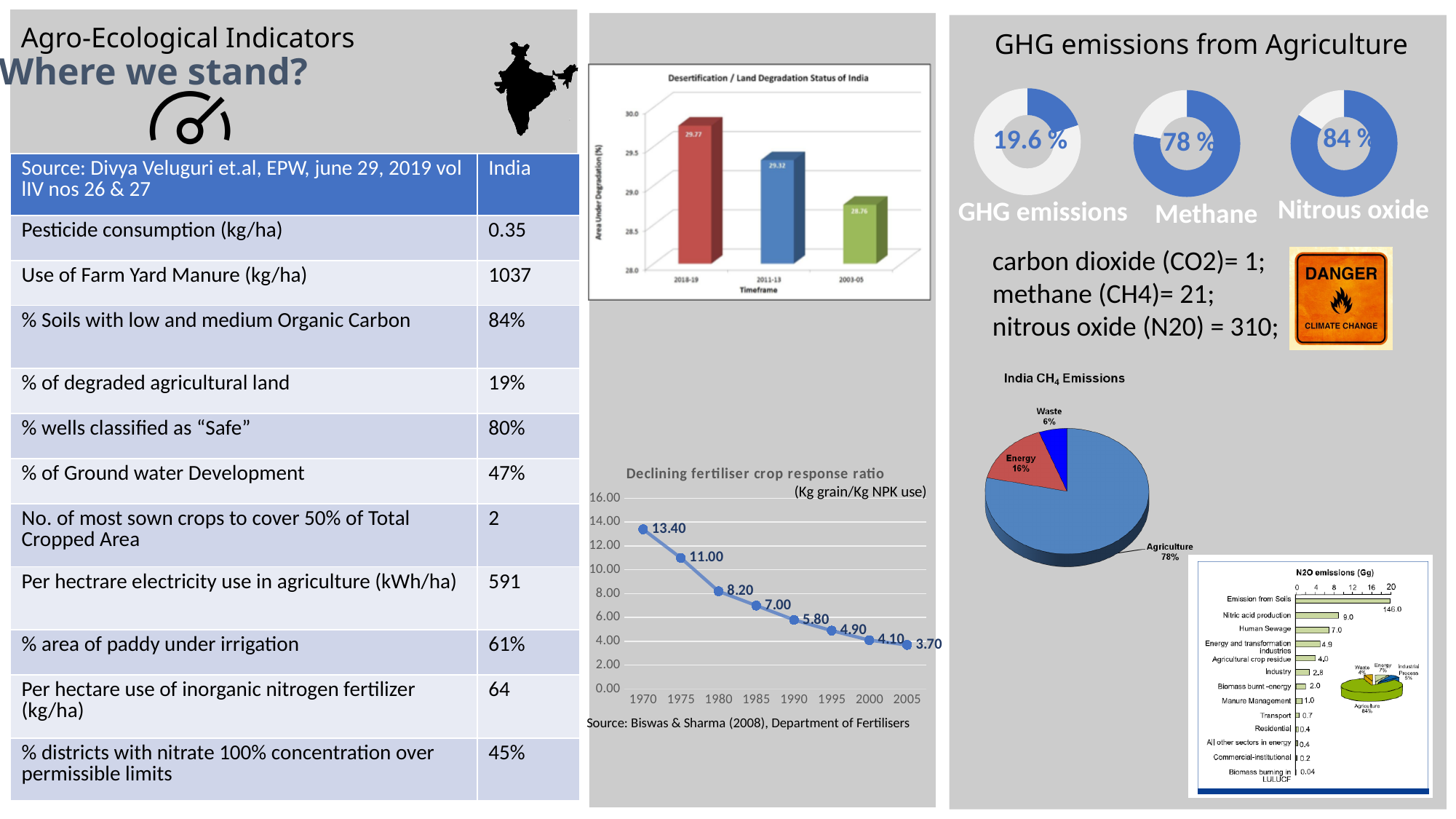
In the 'Declining fertiliser crop response ratio' line chart, what is the value for 1970? 13.40 In the 'N2O emissions (Gg)' bar chart, which is larger: Nitric acid production or Human Sewage? Nitric acid production In the 'Declining fertiliser crop response ratio' line chart, what is the difference between the 1970 value and the 1980 value? 5.20 In the 'Declining fertiliser crop response ratio' line chart, what is the value for 2005? 3.70 How many data points are plotted in the 'Declining fertiliser crop response ratio' line chart? 8 What kind of chart is the 'Desertification / Land Degradation Status of India' chart? bar chart In the 'India CH4 Emissions' pie chart, which category has the smallest slice? Waste In the 'Desertification / Land Degradation Status of India' bar chart, what is the value for 2018-19? 29.77 In the 'India CH4 Emissions' pie chart, what share does Agriculture have? 78% In the 'Desertification / Land Degradation Status of India' bar chart, which timeframe has the lowest value? 2003-05 In the 'N2O emissions (Gg)' bar chart, what is the value for Emission from Soils? 146.0 In the 'Declining fertiliser crop response ratio' line chart, do the values rise or fall from 1970 to 2005? fall